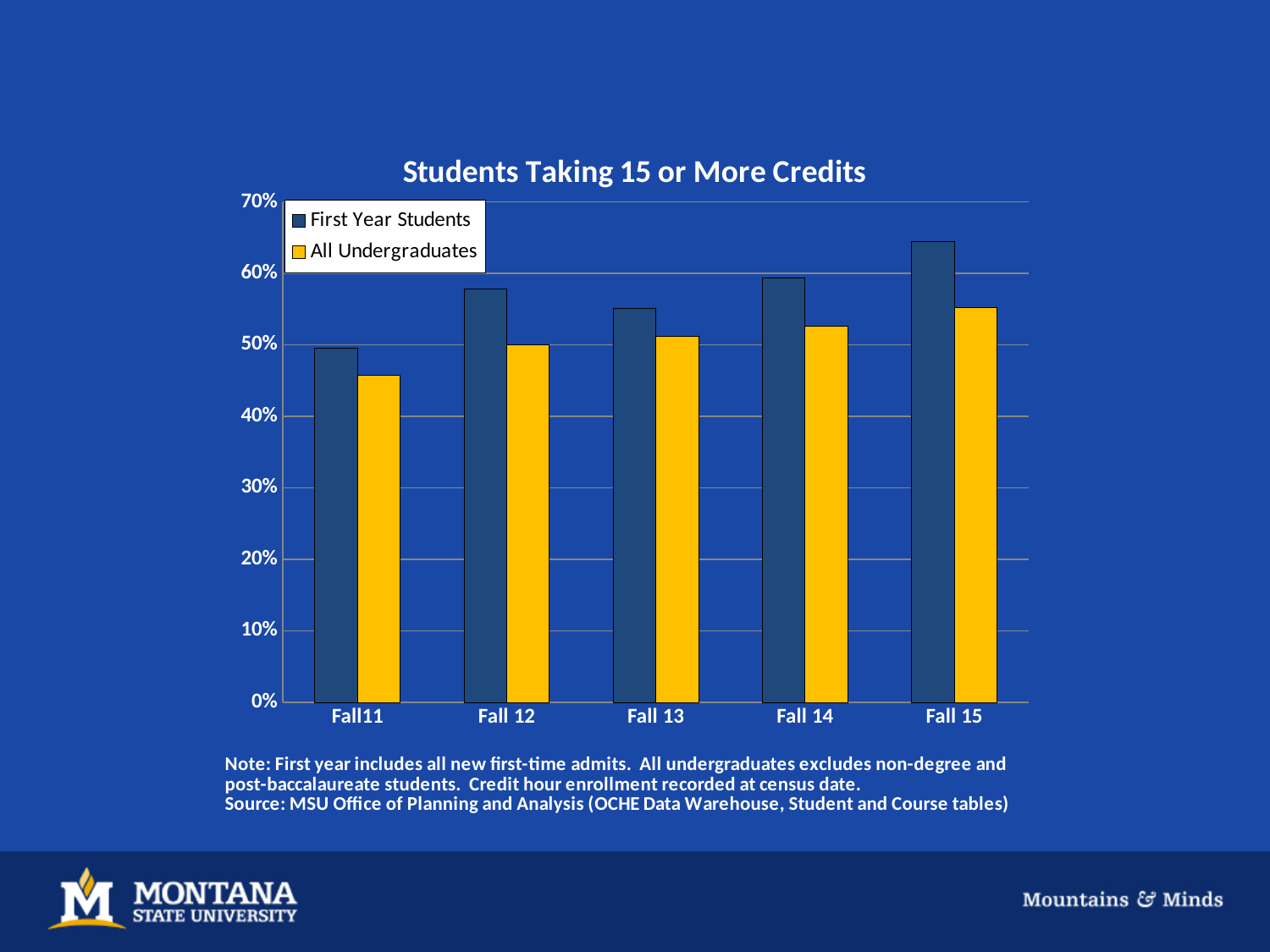
How many fall terms are shown on the x axis? 5 Do the All Undergraduates values rise or fall from Fall11 to Fall 15? rise In which term is the All Undergraduates value lowest? Fall11 How many series does the legend list? 2 In Fall 13, which is larger: First Year Students or All Undergraduates? First Year Students Is the All Undergraduates value for Fall11 greater or less than 50%? less What is the title of the chart? Students Taking 15 or More Credits Is the All Undergraduates value for Fall 15 greater or less than 50%? greater What kind of chart is shown on the slide? Bar chart In which term is the First Year Students value highest? Fall 15 Which series is shown in yellow? All Undergraduates Is the First Year Students value for Fall 15 greater or less than 60%? greater